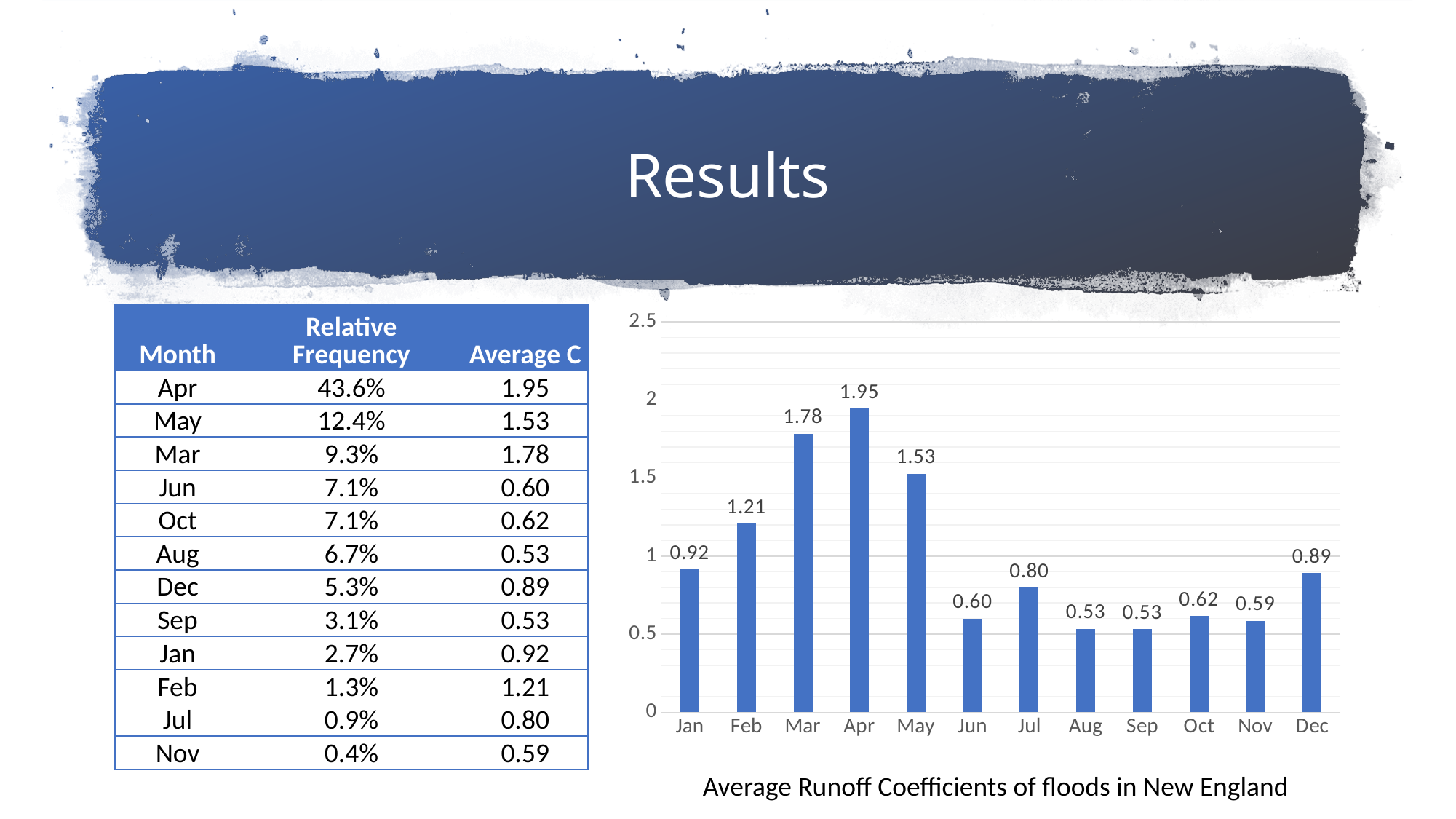
What is the value for Apr in the bar chart? 1.95 What kind of chart is shown on the slide? bar chart What is the difference between the values for Apr and May in the bar chart? 0.42 How many months are shown on the x axis of the bar chart? 12 Which months share the lowest value in the bar chart? Aug and Sep Which is larger in the bar chart, the value for Jan or the value for Dec? Jan Do the values in the bar chart rise or fall from Jan to Apr? rise Which month has the highest value in the bar chart? Apr What is the caption below the bar chart? Average Runoff Coefficients of floods in New England What is the value for Jul in the bar chart? 0.80 What is the highest tick value on the y axis of the bar chart? 2.5 Is the value for Mar in the bar chart greater or less than 1.5? greater